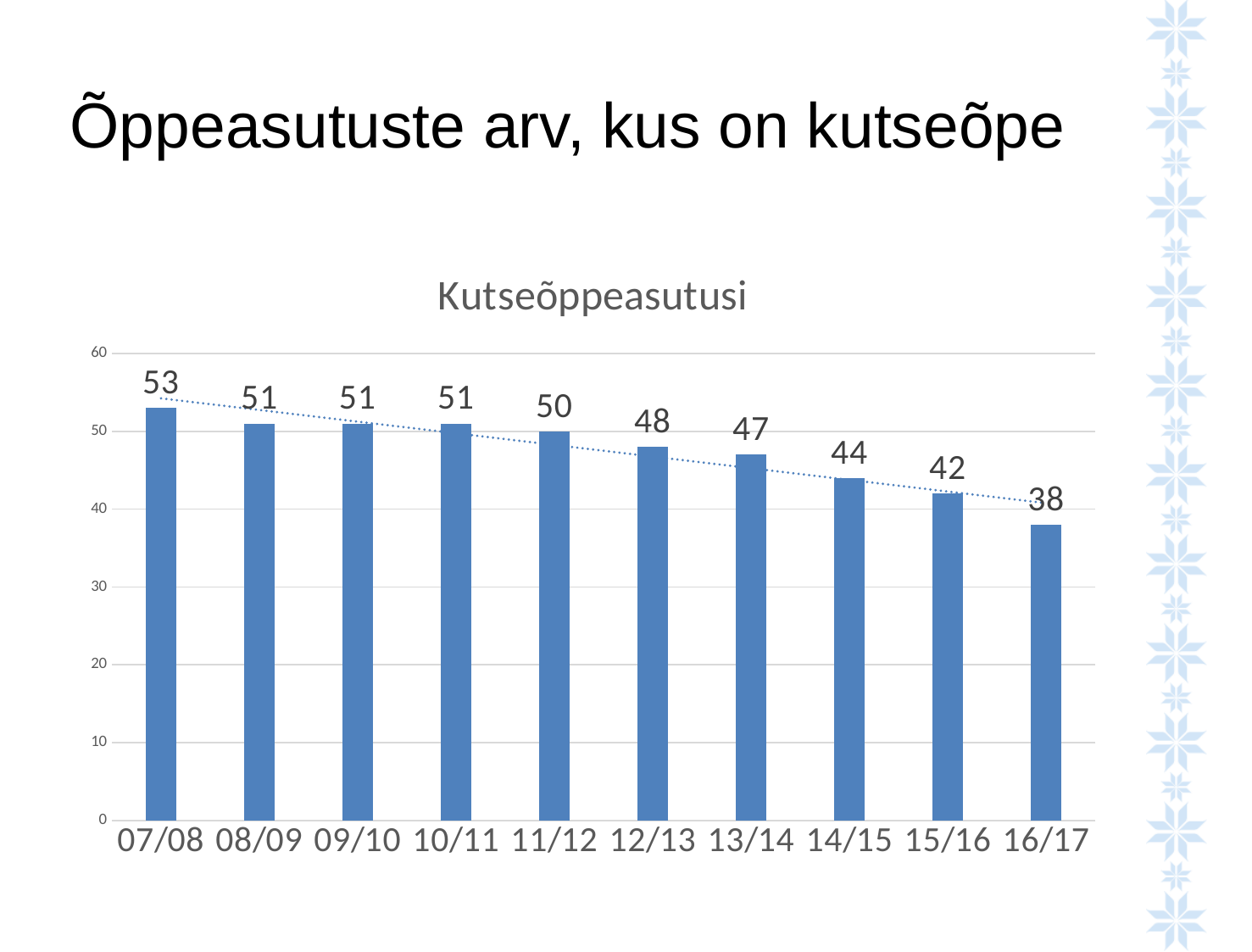
What is the value for 13/14? 47 What is the value for 07/08? 53 Which is larger, the value for 11/12 or the value for 14/15? 11/12 What kind of chart is this? bar chart Is the value for 16/17 greater or less than 40? less How many categories are shown on the x axis? 10 Do the values rise or fall from 07/08 to 16/17? fall What is the value for 16/17? 38 Which category has the lowest value? 16/17 What is the difference between the values for 07/08 and 16/17? 15 What is the difference between the values for 14/15 and 15/16? 2 Which category has the highest value? 07/08